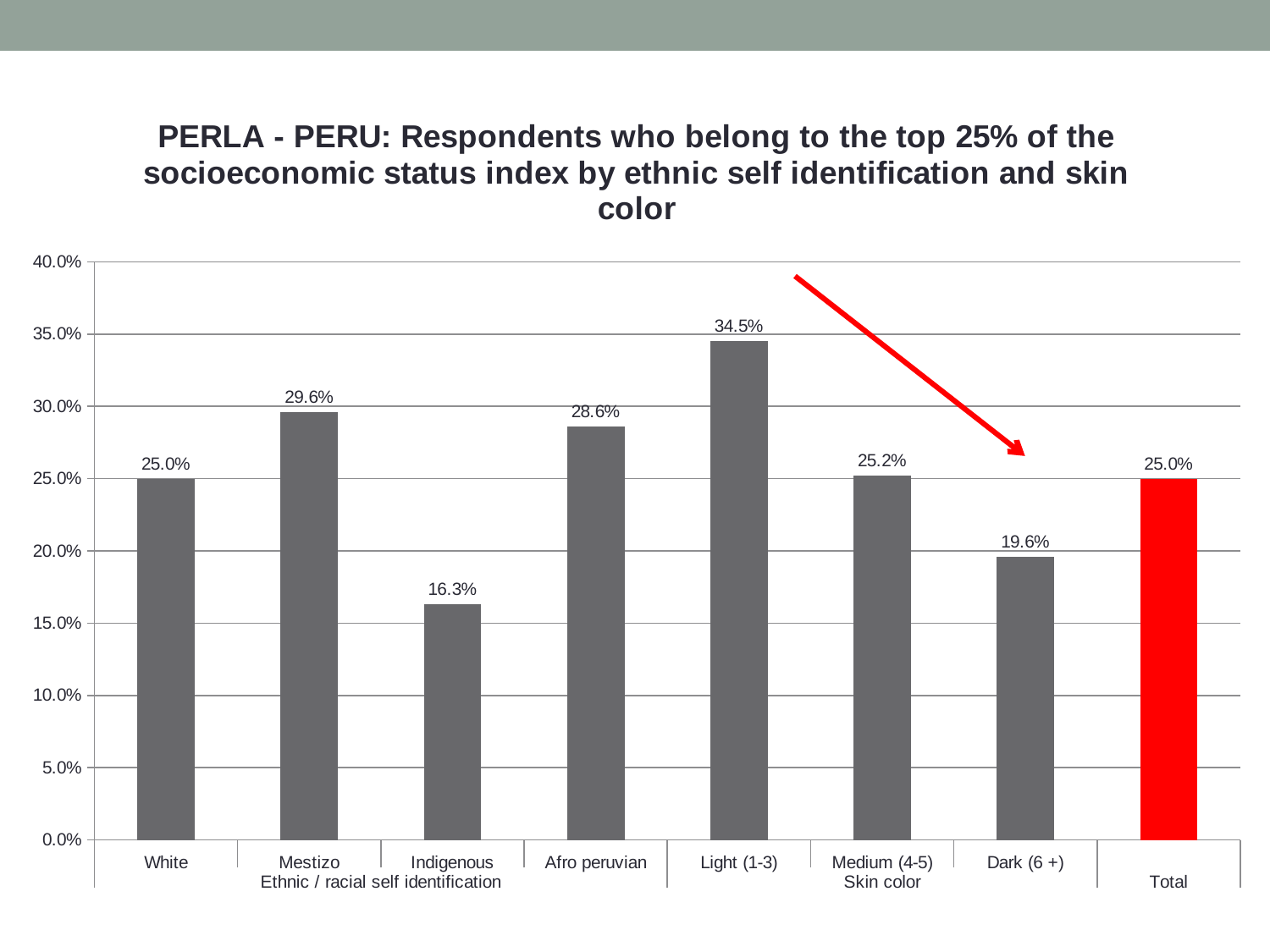
Which category has the highest value? Light (1-3) What is the value for Mestizo? 29.6% What is the value for Dark (6 +)? 19.6% How many bars are shown in the chart? 8 What kind of chart is shown on the slide? Bar chart What is the value for Light (1-3)? 34.5% Do the values rise or fall across the skin color categories from Light (1-3) to Dark (6 +)? Fall Which category has the lowest value? Indigenous What is the value for Total? 25.0% What is the difference between the values for Light (1-3) and Dark (6 +)? 14.9% What is the difference between the values for Mestizo and Indigenous? 13.3% Which is larger, the value for Afro peruvian or the value for White? Afro peruvian